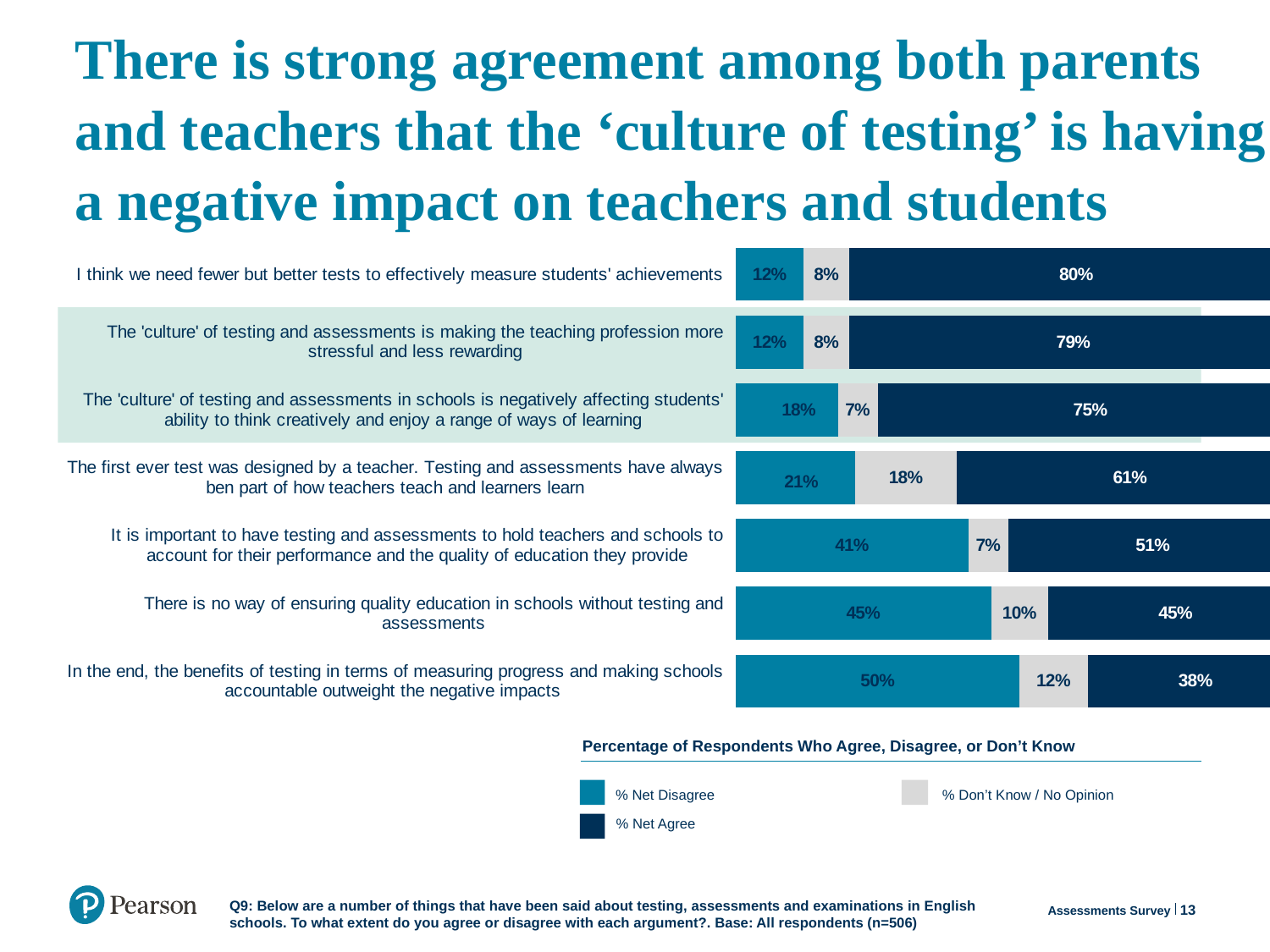
What percentage of respondents net agree that we need fewer but better tests to effectively measure students' achievements? 80% Which statement has the lowest % Net Agree? In the end, the benefits of testing in terms of measuring progress and making schools accountable outweigh the negative impacts What is the difference between the % Net Agree and % Net Disagree for the statement that it is important to have testing and assessments to hold teachers and schools to account? 10% Which statement has the highest % Net Agree? I think we need fewer but better tests to effectively measure students' achievements Is the % Net Agree for the statement that the 'culture' of testing is making the teaching profession more stressful larger than the % Net Agree for the statement that the first ever test was designed by a teacher? Yes How many statements are shown in the chart? 7 For the statement that there is no way of ensuring quality education without testing, is % Net Agree or % Net Disagree larger? They are equal (45% each) How many series does the legend list? 3 Which series is shown in the dark navy colour in the legend? % Net Agree What kind of chart is shown on the slide? Stacked bar chart What percentage of respondents answered Don't Know / No Opinion for the statement that the first ever test was designed by a teacher? 18% What percentage of respondents net disagree that the benefits of testing outweigh the negative impacts? 50%